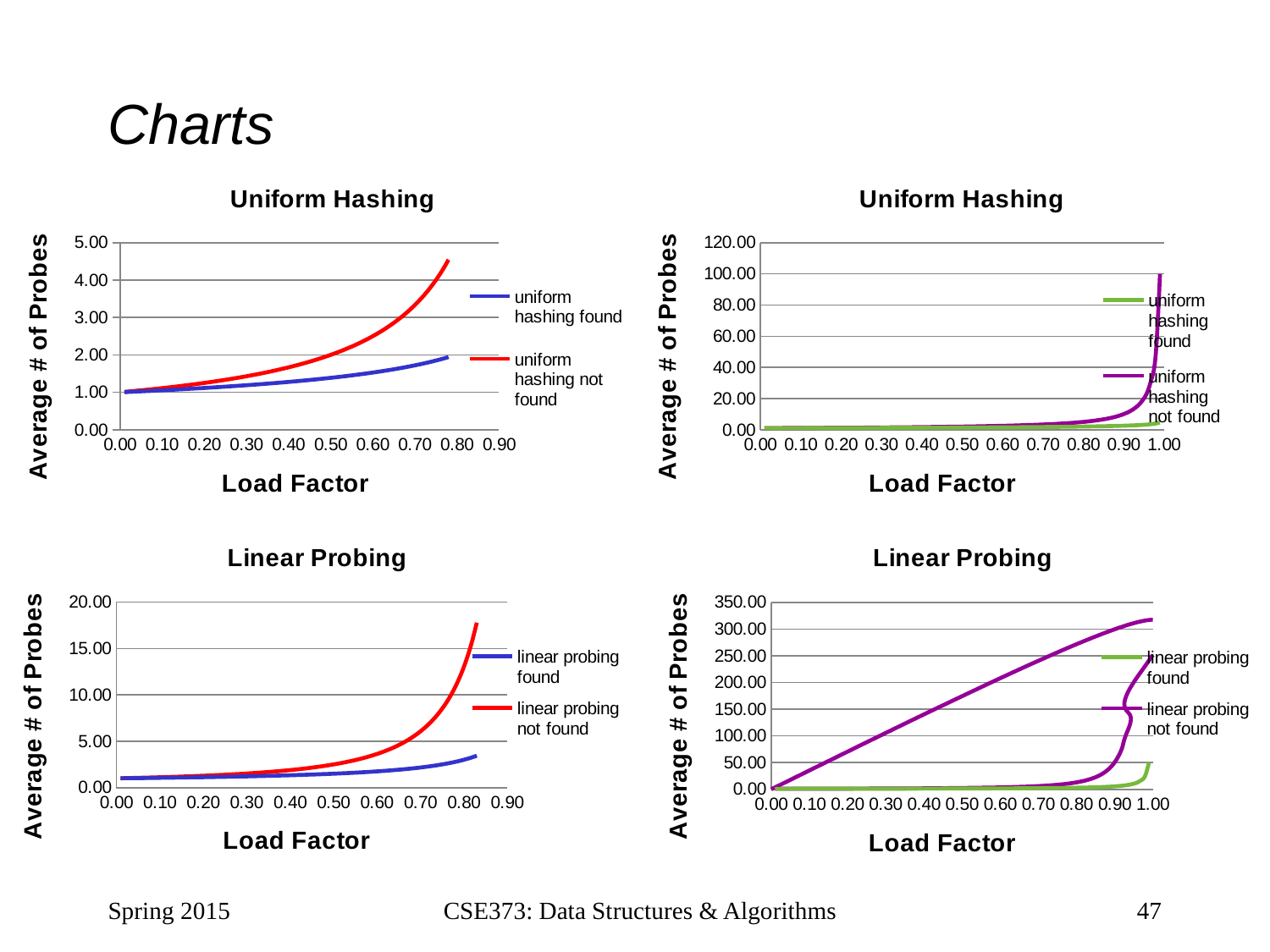
In the top-left "Uniform Hashing" chart, is the highest value of the "uniform hashing not found" line greater or less than 4.00? greater In the bottom-right "Linear Probing" chart, which series is higher at a load factor of 0.50? linear probing not found In the bottom-left "Linear Probing" chart, is the value of "linear probing found" at a load factor of 0.80 greater or less than 5.00? less In the bottom-left "Linear Probing" chart, is the highest value of the "linear probing not found" line greater or less than 15.00? greater In the top-left "Uniform Hashing" chart, which series is higher at a load factor of 0.70? uniform hashing not found What is the x-axis title of the bottom-right "Linear Probing" chart? Load Factor How many series does the legend of the top-left "Uniform Hashing" chart list? 2 What kind of chart is the top-left chart titled "Uniform Hashing"? line chart What is the y-axis title of the bottom-left "Linear Probing" chart? Average # of Probes In the top-left "Uniform Hashing" chart, does the "uniform hashing not found" line rise or fall as the load factor increases? rises How many series does the legend of the bottom-right "Linear Probing" chart list? 2